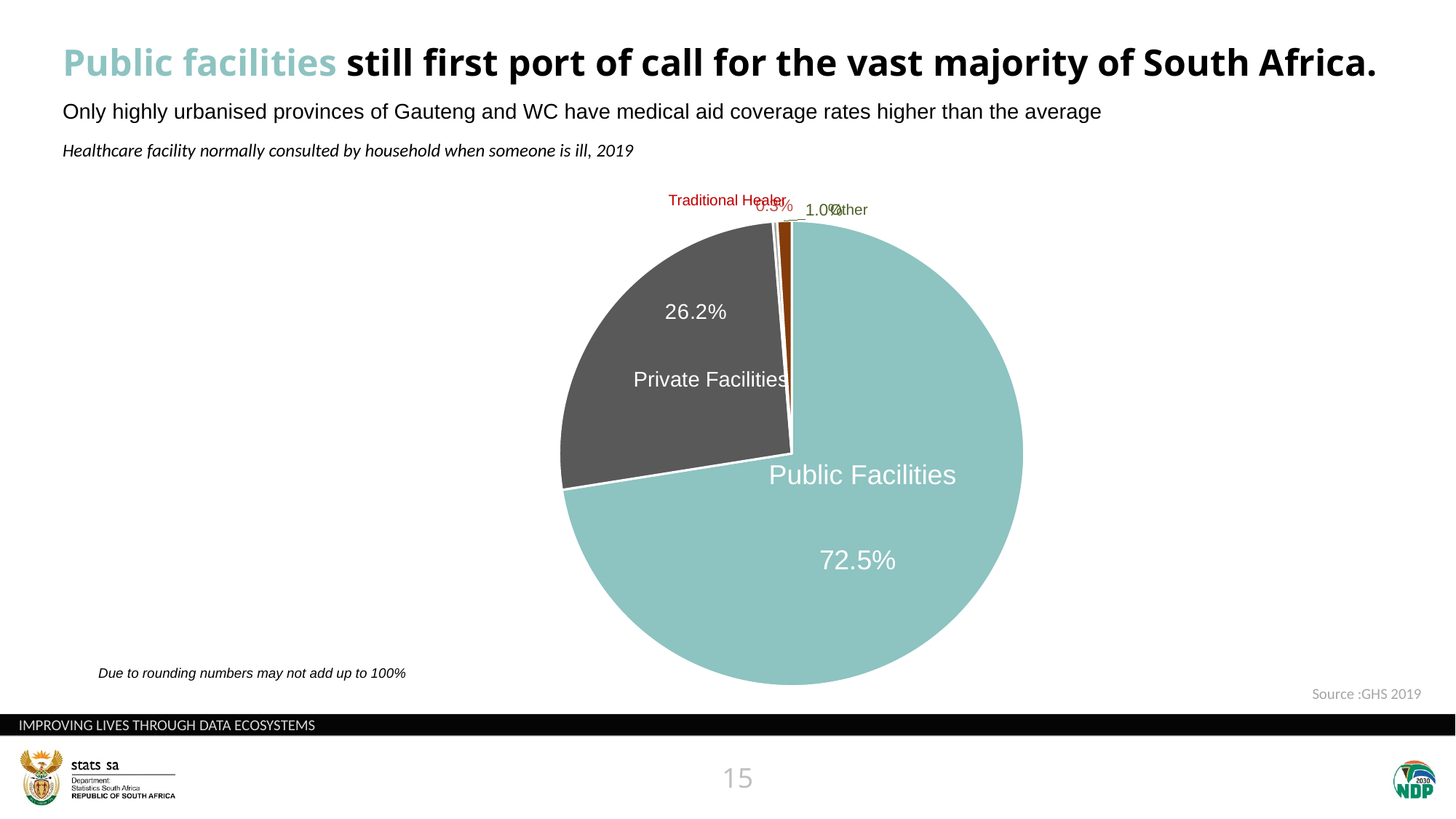
What is the source cited for the chart data? GHS 2019 Which healthcare facility category has the largest share of the pie? Public Facilities What percentage is shown for the Other category? 1.0% What is the difference in percentage points between Public Facilities and Private Facilities? 46.3 percentage points How many categories are shown in the pie chart? 4 Which is larger, the share for Public Facilities or for Private Facilities? Public Facilities What percentage of households normally consult Public Facilities when someone is ill? 72.5% What kind of chart is shown on the slide? Pie chart What is the title of the chart? Healthcare facility normally consulted by household when someone is ill, 2019 What percentage of households normally consult Private Facilities? 26.2% What is the combined share of Public Facilities and Private Facilities? 98.7% What share of the pie does Public Facilities represent? 72.5%